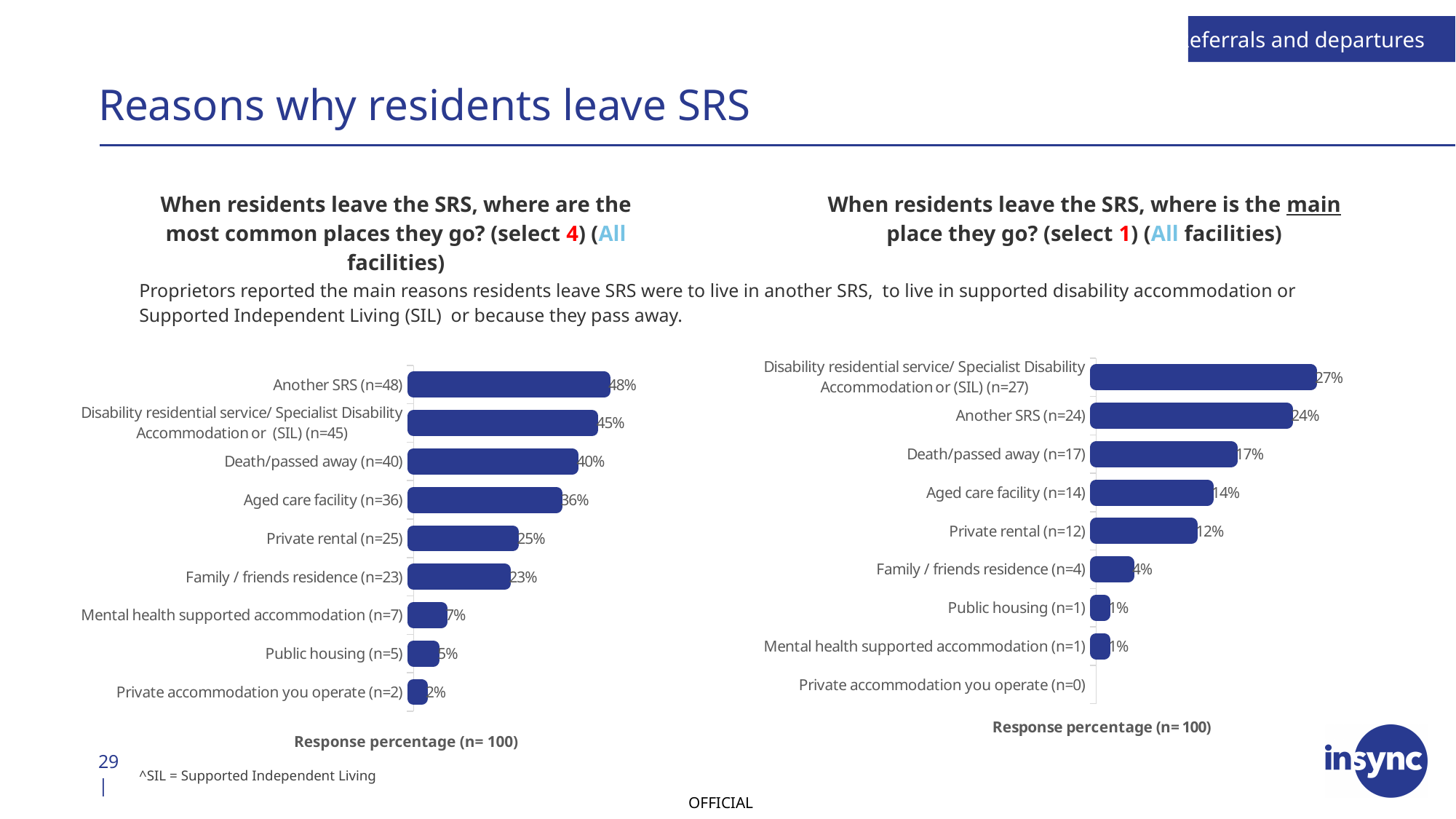
In the right chart (main place residents go, select 1), what is the value for Public housing? 1% In the left chart (most common places residents go, select 4), what is the value for Aged care facility? 36% What type of chart is used on this slide? Bar chart In the left chart (most common places residents go, select 4), what is the value for Another SRS? 48% In the left chart (most common places residents go, select 4), how many categories are plotted? 9 In the left chart (most common places residents go, select 4), which category has the lowest value? Private accommodation you operate In the right chart (main place residents go, select 1), what is the difference between Another SRS and Death/passed away? 7% In the right chart (main place residents go, select 1), which category has the highest value? Disability residential service/ Specialist Disability Accommodation or (SIL) In the right chart (main place residents go, select 1), what is the value for Disability residential service/ Specialist Disability Accommodation or (SIL)? 27% In the left chart (most common places residents go, select 4), what is the difference between Another SRS and Death/passed away? 8% In the right chart (main place residents go, select 1), which is larger: Private rental or Family / friends residence? Private rental What is the x-axis label of the left chart? Response percentage (n= 100)